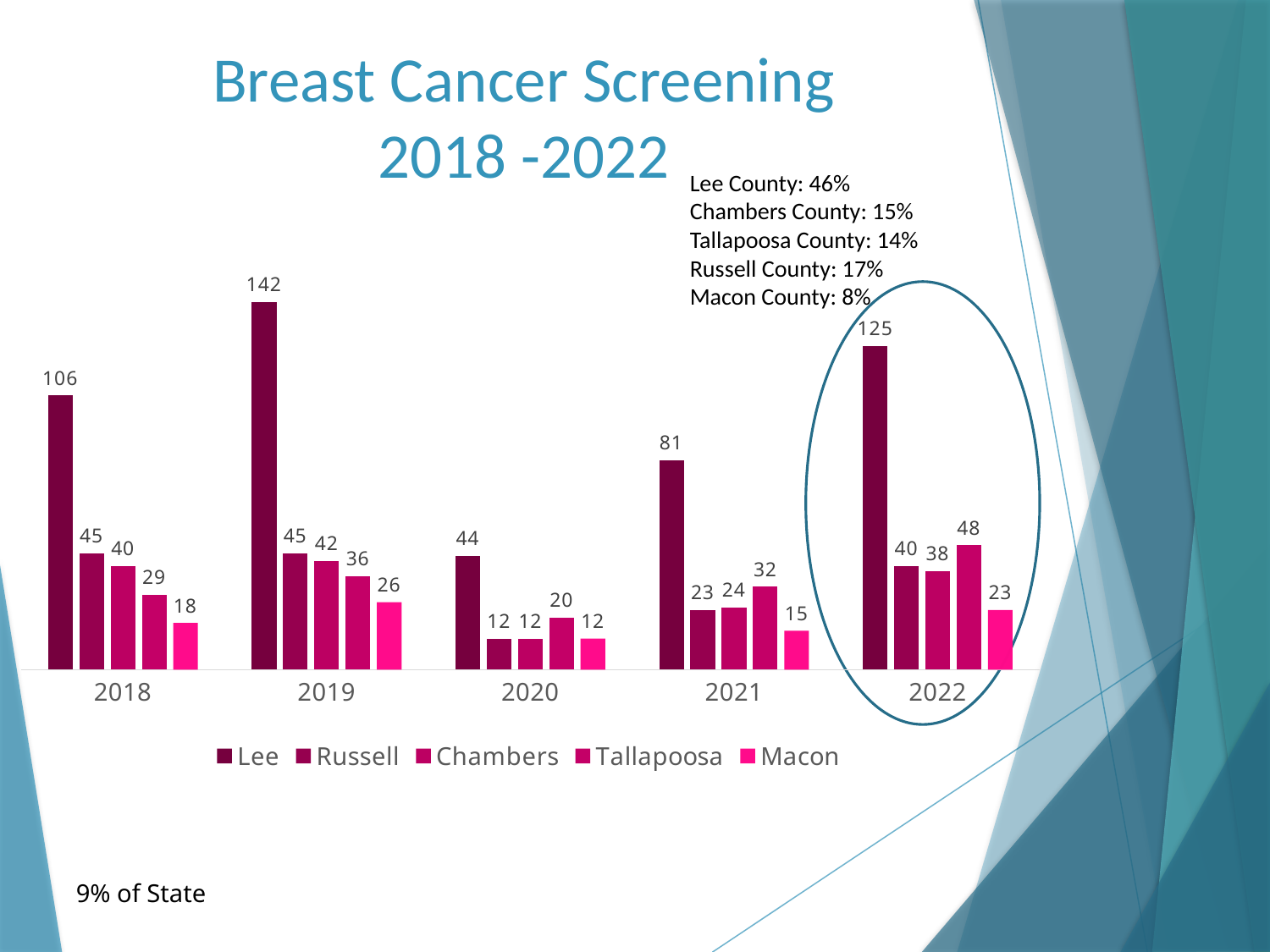
What is the difference between the Lee values in 2019 and 2022? 17 What is the title of the chart? Breast Cancer Screening 2018 -2022 Which is larger in 2022, the Russell value or the Tallapoosa value? Tallapoosa What kind of chart is shown on the slide? Bar chart In which year is the Lee value highest? 2019 What is the value for Macon in 2020? 12 How many series does the legend list? 5 In which year is the Lee value lowest? 2020 What is the value for Lee in 2019? 142 Does the Lee value rise or fall from 2020 to 2022? Rise What is the value for Tallapoosa in 2022? 48 How many years are shown on the x axis? 5